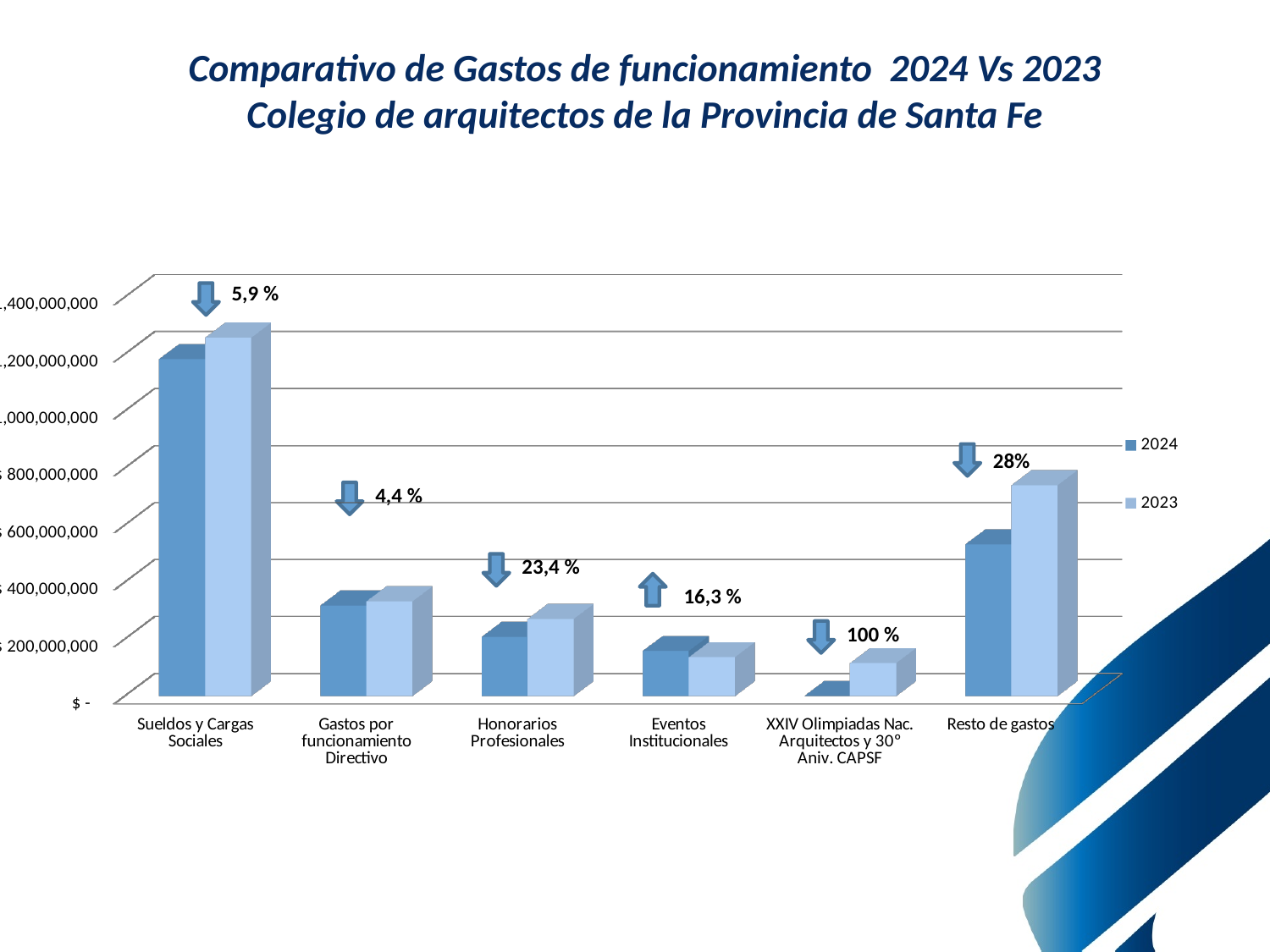
How many series does the chart legend list? 2 What percentage change is annotated above the Honorarios Profesionales bars? 23,4 % For Eventos Institucionales, which year has the larger value, 2024 or 2023? 2024 Is the 2023 value for Resto de gastos greater or less than 600,000,000? greater Which category is marked with an upward arrow indicating an increase from 2023 to 2024? Eventos Institucionales What kind of chart is shown on the slide? Bar chart For Sueldos y Cargas Sociales, which year has the larger value, 2024 or 2023? 2023 Which category has the lowest value for 2024? XXIV Olimpiadas Nac. Arquitectos y 30° Aniv. CAPSF Is the 2024 value for Gastos por funcionamiento Directivo greater or less than 400,000,000? less What percentage change is annotated above the Resto de gastos bars? 28% Which category has the highest value for 2024? Sueldos y Cargas Sociales How many categories are shown on the x axis of the chart? 6